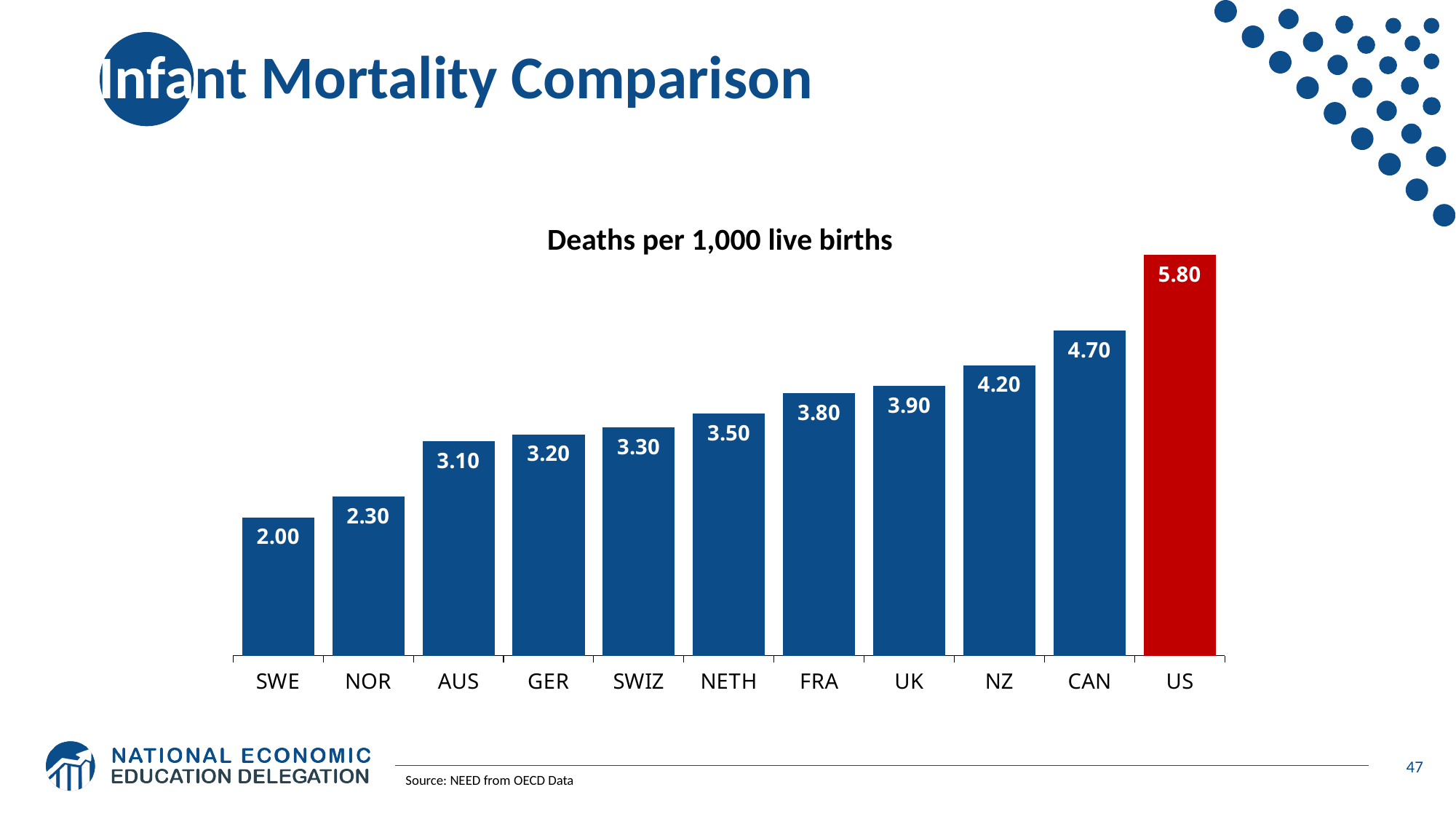
What is the difference between the values for the US and CAN? 1.10 Do the values rise or fall from left to right along the x axis? Rise How many countries are shown on the chart? 11 What is the title of the chart? Deaths per 1,000 live births What is the value for NETH? 3.50 What is the difference between the values for AUS and NOR? 0.80 What is the value for the US? 5.80 Which country has the lowest value? SWE What is the value for SWE? 2.00 What kind of chart is this? Bar chart Which is larger, the value for NZ or the value for FRA? NZ Which country has the highest value? US